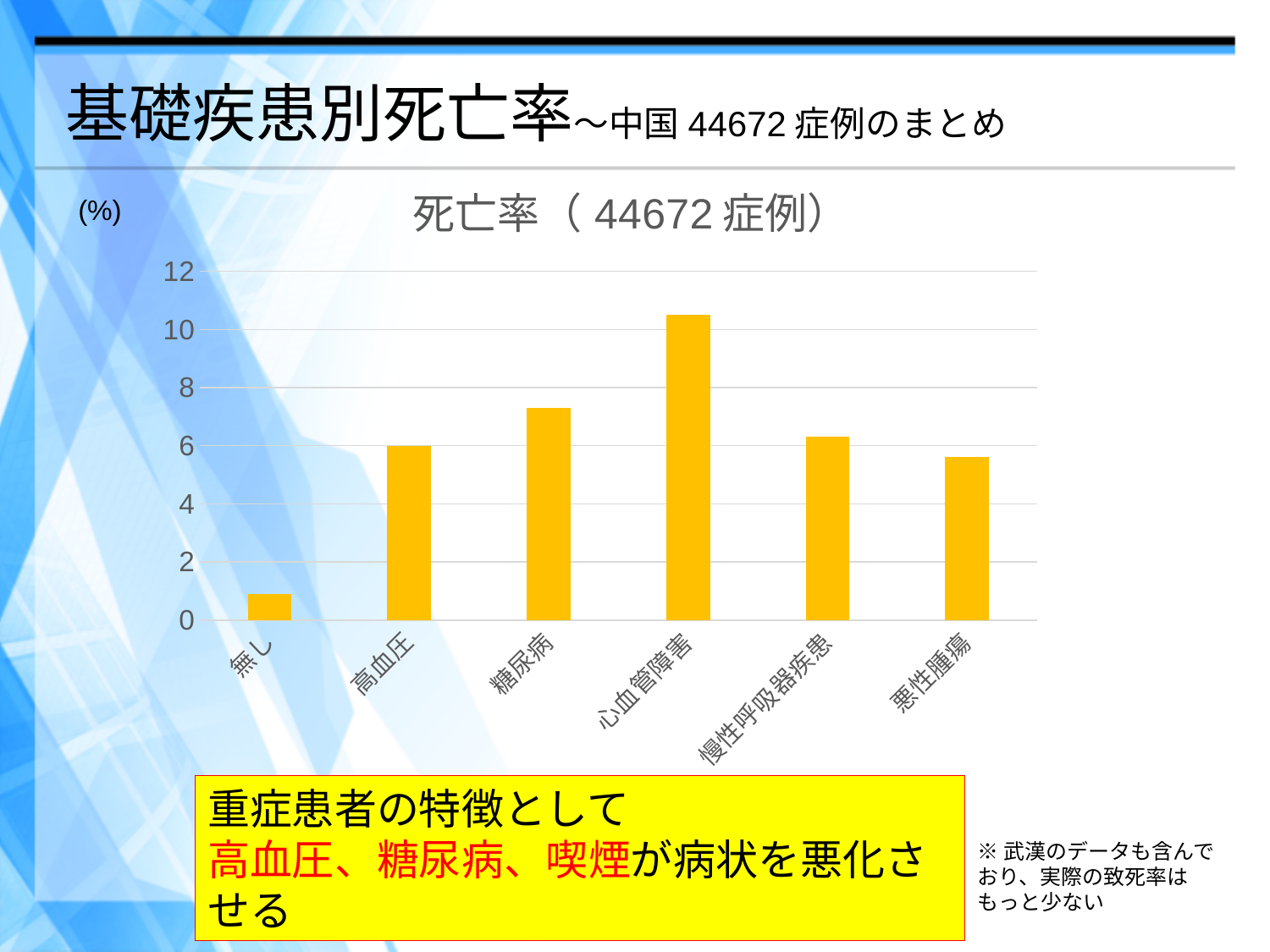
Is the value for 心血管障害 greater or less than 10? greater Which category has the lowest death rate in the chart? 無し How many categories are plotted on the x axis of the chart? 6 Is the value for 糖尿病 greater or less than 6? greater Is the value for 悪性腫瘍 greater or less than 6? less Which category has the highest death rate in the chart? 心血管障害 What kind of chart is shown on the slide? bar chart Which has a higher death rate, 糖尿病 or 高血圧? 糖尿病 Which has a higher death rate, 心血管障害 or 慢性呼吸器疾患? 心血管障害 What is the title of the chart? 死亡率（44672症例）